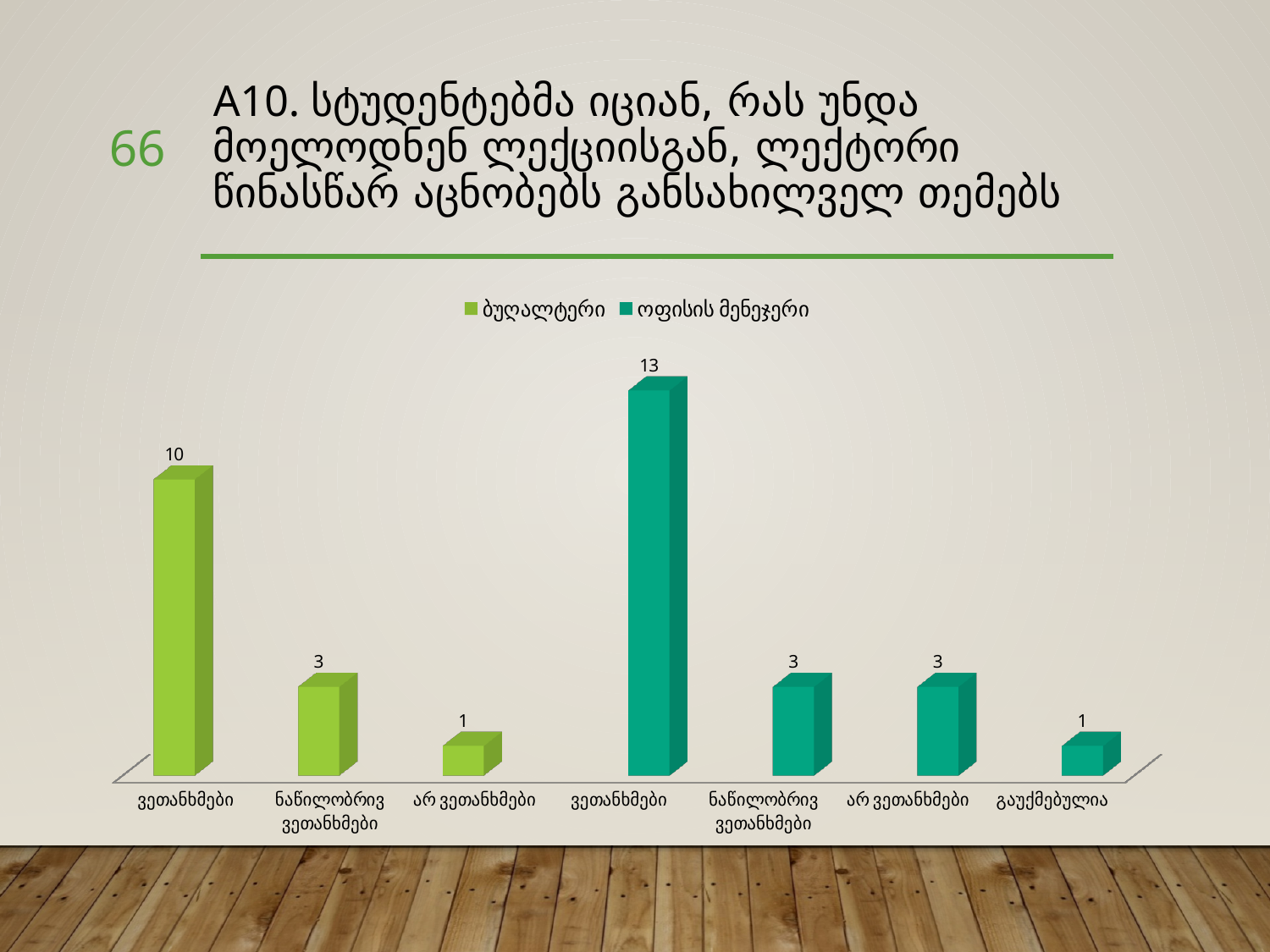
What is the value of the ბუღალტერი bar for არ ვეთანხმები? 1 What is the value of the ოფისის მენეჯერი bar for გაუქმებულია? 1 How many bars are plotted on the chart? 7 What is the value of the ბუღალტერი bar for ვეთანხმები? 10 What are the two series named in the legend? ბუღალტერი and ოფისის მენეჯერი Which is larger: the არ ვეთანხმები value for ბუღალტერი or for ოფისის მენეჯერი? ოფისის მენეჯერი What is the difference between the ვეთანხმები values for ოფისის მენეჯერი and ბუღალტერი? 3 Which bar has the highest value on the chart? ოფისის მენეჯერი – ვეთანხმები (13) What is the total of the three ბუღალტერი bars? 14 What kind of chart is shown on the slide? Bar chart What is the value of the ოფისის მენეჯერი bar for ვეთანხმები? 13 How many series does the legend list? 2